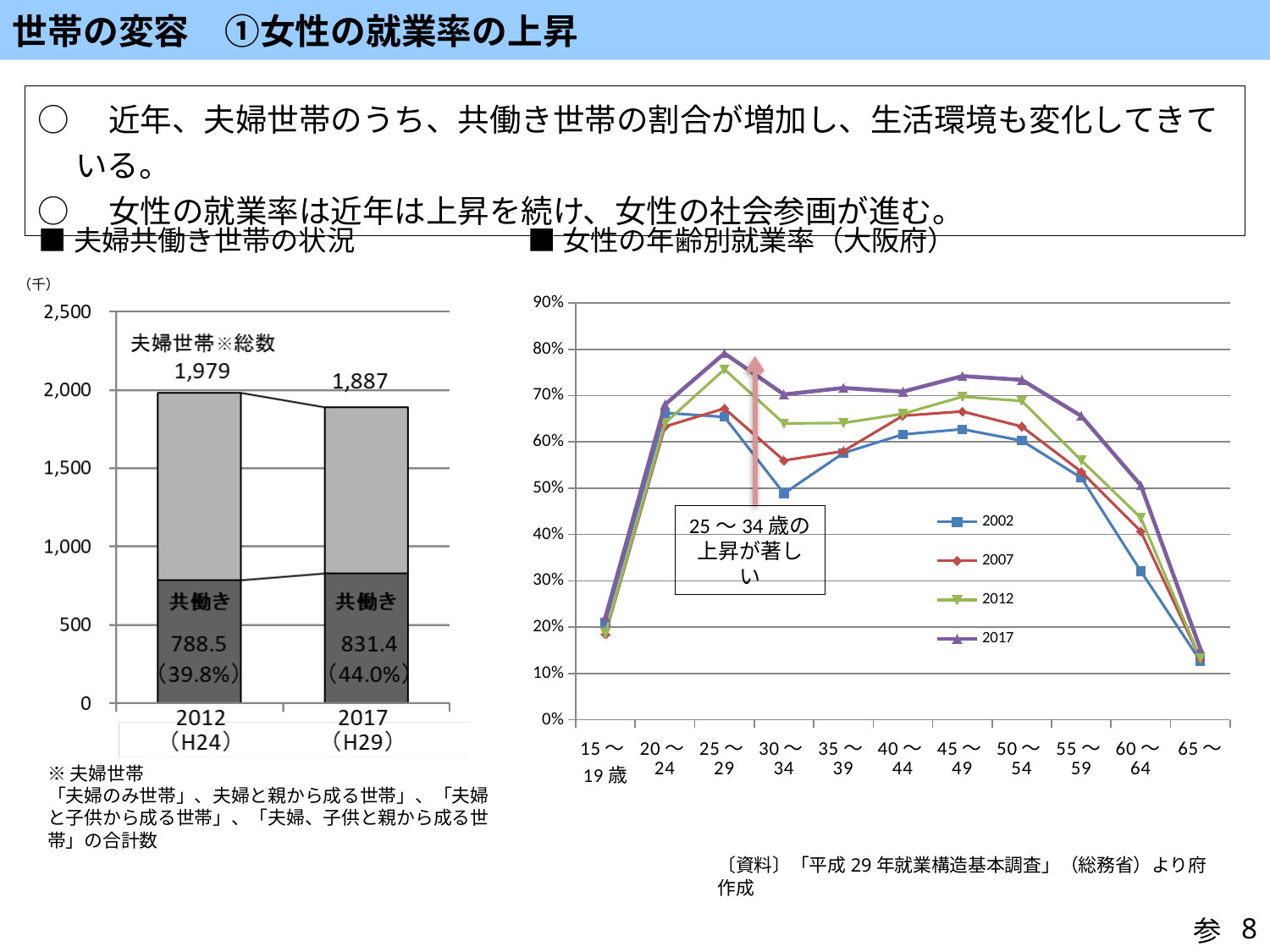
In the left chart (夫婦共働き世帯の状況), what is the total number of 夫婦世帯 in 2012? 1,979 In the left chart (夫婦共働き世帯の状況), by how much did the 共働き value increase from 2012 to 2017? 42.9 In the left chart (夫婦共働き世帯の状況), which year has the larger 共働き value, 2012 or 2017? 2017 In the left chart (夫婦共働き世帯の状況), what is the 共働き value for 2017? 831.4 In the right chart (女性の年齢別就業率（大阪府）), for the 30～34 age group, which series has the larger value, 2002 or 2017? 2017 How many series does the legend of the right chart (女性の年齢別就業率（大阪府）) list? 4 What kind of chart is the left chart (夫婦共働き世帯の状況)? Bar chart How many age groups are shown on the x axis of the right chart (女性の年齢別就業率（大阪府）)? 11 In the left chart (夫婦共働き世帯の状況), by how much did the 夫婦世帯 total decrease from 2012 to 2017? 92 In the left chart (夫婦共働き世帯の状況), what percentage share does 共働き have in 2012? 39.8% In the right chart (女性の年齢別就業率（大阪府）), is the 2017 value for the 25～29 age group greater or less than 70%? greater In the right chart (女性の年齢別就業率（大阪府）), which age group has the highest value for the 2017 series? 25～29